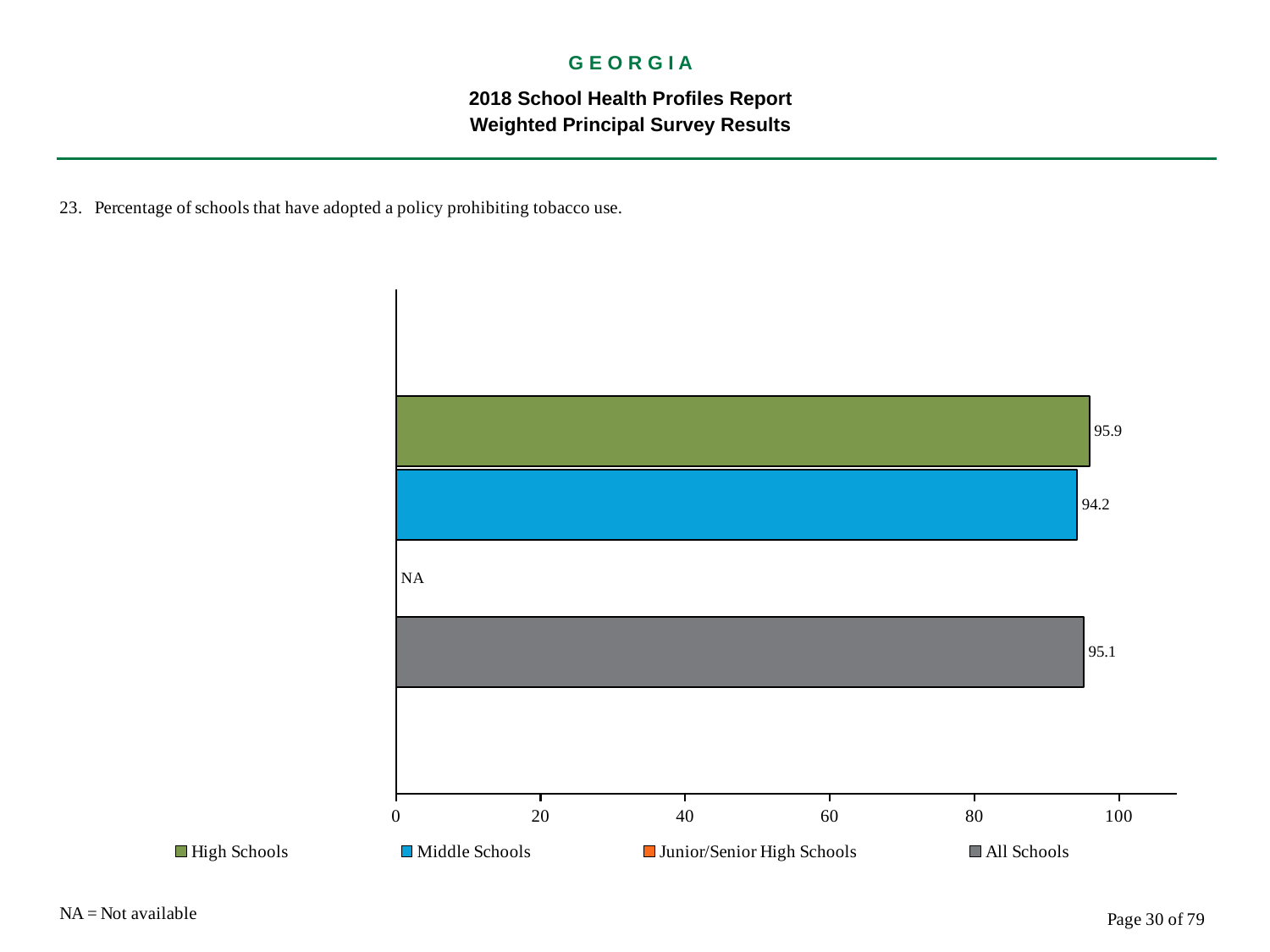
What kind of chart is this? bar chart What is the value for High Schools? 95.9 What is the value for Middle Schools? 94.2 Which is larger, the value for All Schools or the value for Middle Schools? All Schools Which school type with a plotted value has the lowest value? Middle Schools Is the value for High Schools greater or less than 80? greater What is shown for Junior/Senior High Schools? NA What does NA stand for on this slide? Not available What is the difference between the High Schools value and the Middle Schools value? 1.7 What is the value for All Schools? 95.1 How many series does the legend list? 4 Which school type has the highest value? High Schools